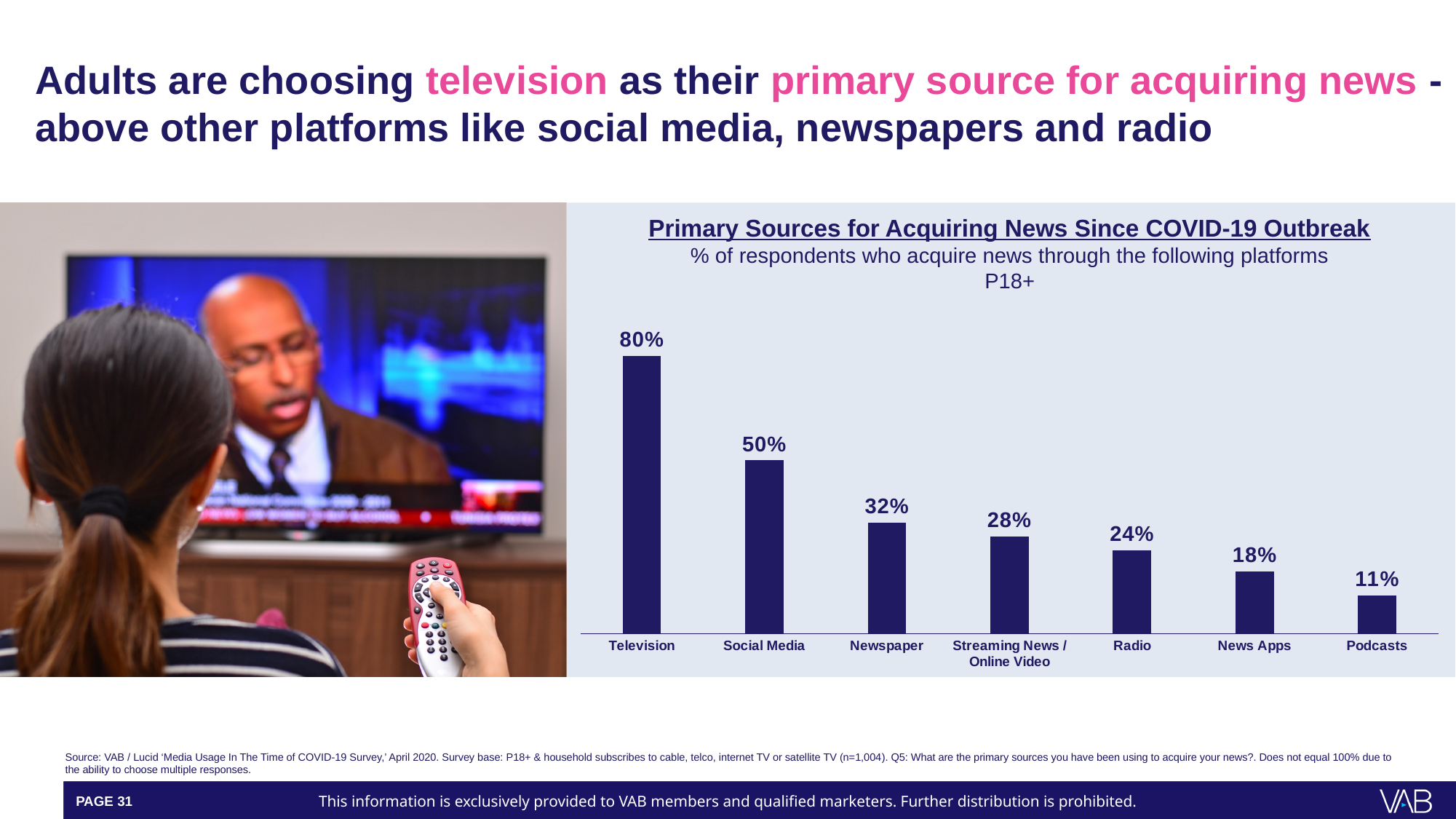
How many platforms are shown in the chart? 7 What is the value shown for Streaming News / Online Video? 28% Which has a higher value, Radio or News Apps? Radio Which platform has the lowest percentage of respondents? Podcasts What is the value shown for News Apps? 18% What type of chart is used on this slide? Bar chart What is the difference in percentage points between Television and Social Media? 30 What is the title of the chart? Primary Sources for Acquiring News Since COVID-19 Outbreak What is the difference in percentage points between Newspaper and Radio? 8 What percentage of respondents acquire news through Social Media? 50% Which platform has the highest percentage of respondents? Television What percentage of respondents acquire news through Television? 80%